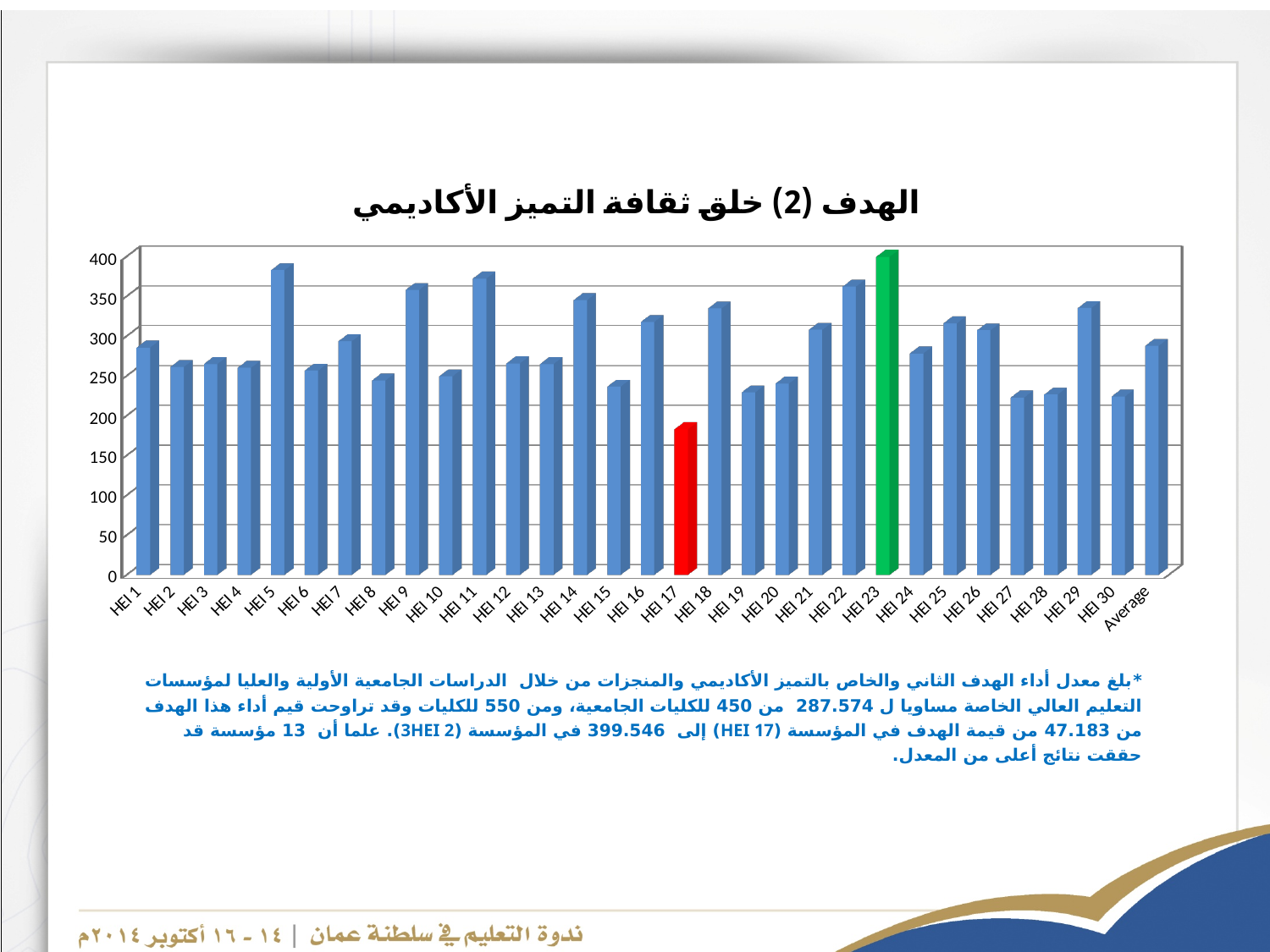
Which category has the highest bar in the chart? HEI 23 How many HEI categories (excluding Average) are plotted on the x axis? 30 Which category's bar is coloured red? HEI 17 Is the value for HEI 5 greater or less than 350? greater Which is larger, the value for HEI 19 or the value for HEI 21? HEI 21 Which is larger, the value for HEI 5 or the value for HEI 1? HEI 5 What kind of chart is shown on the slide? bar chart Is the value for HEI 17 greater or less than 200? less Is the value for Average greater or less than 250? greater Which category has the lowest bar in the chart? HEI 17 Which category's bar is coloured green? HEI 23